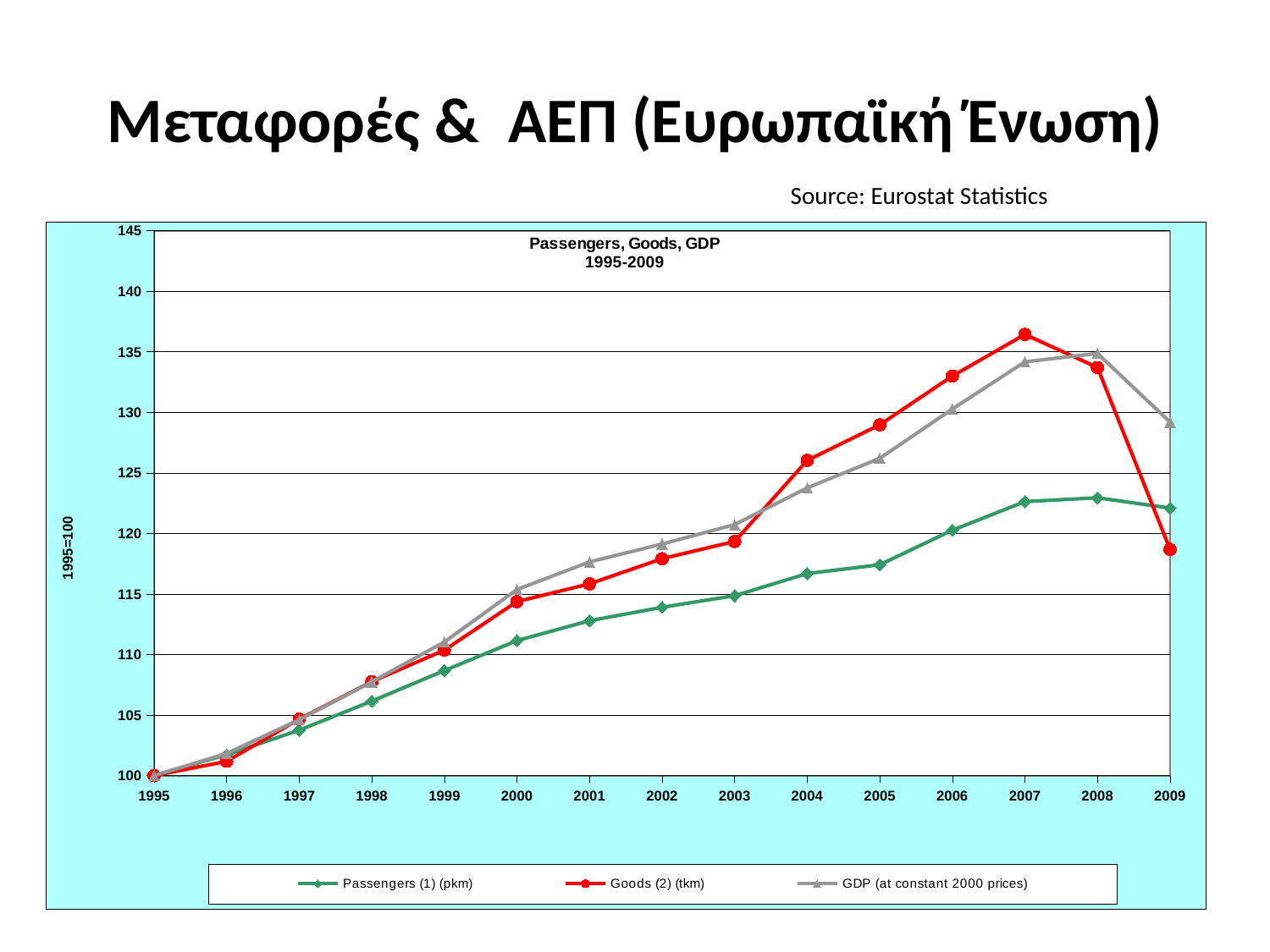
What is the value of the Goods (2) (tkm) series in 1995? 100 Does the Goods (2) (tkm) series rise or fall from 2007 to 2009? Fall Is the value for Goods (2) (tkm) in 2007 greater or less than 135? greater In which year does the Goods (2) (tkm) series reach its highest value? 2007 What is the label on the y axis of the chart? 1995=100 Is the value for Passengers (1) (pkm) in 2009 greater or less than 120? greater Which is larger in 2009, GDP (at constant 2000 prices) or Goods (2) (tkm)? GDP (at constant 2000 prices) What kind of chart is shown on the slide? Line chart How many series does the legend list? 3 Which series has the lowest value in 2009? Goods (2) (tkm) How many years are plotted along the x axis? 15 Does the Passengers (1) (pkm) series rise or fall from 1995 to 2007? Rise